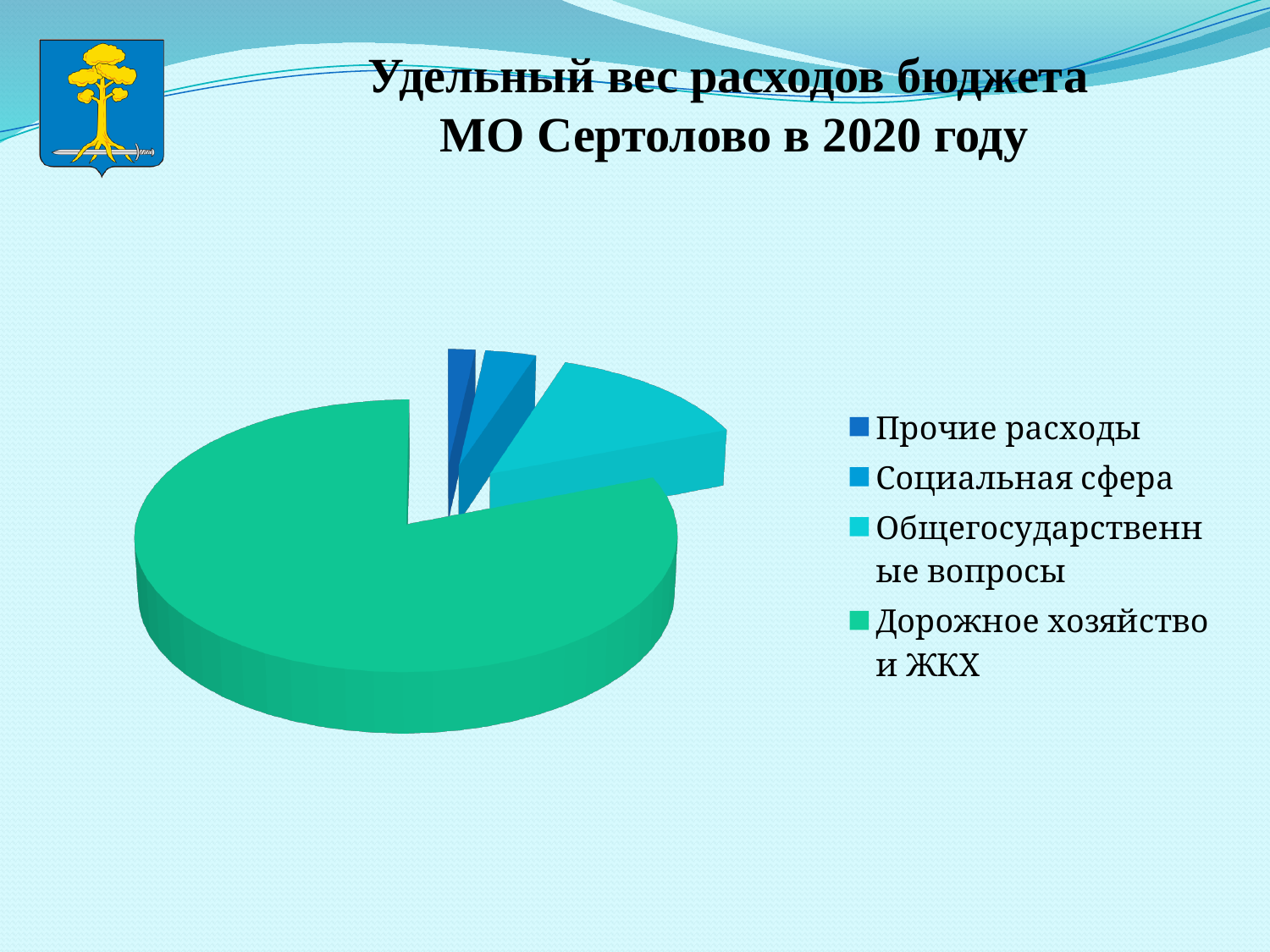
How many entries does the legend of the pie chart list? 4 Which category has the largest slice of the pie chart? Дорожное хозяйство и ЖКХ What kind of chart is shown on the slide? Pie chart Which slice is larger: Дорожное хозяйство и ЖКХ or Общегосударственные вопросы? Дорожное хозяйство и ЖКХ Which category has the smallest slice of the pie chart? Прочие расходы Does the slice for Дорожное хозяйство и ЖКХ take up more or less than half of the pie? More Which slice is larger: Общегосударственные вопросы or Социальная сфера? Общегосударственные вопросы What is the title of the chart on the slide? Удельный вес расходов бюджета МО Сертолово в 2020 году Which legend entry is shown in dark blue? Прочие расходы How many slices does the pie chart have? 4